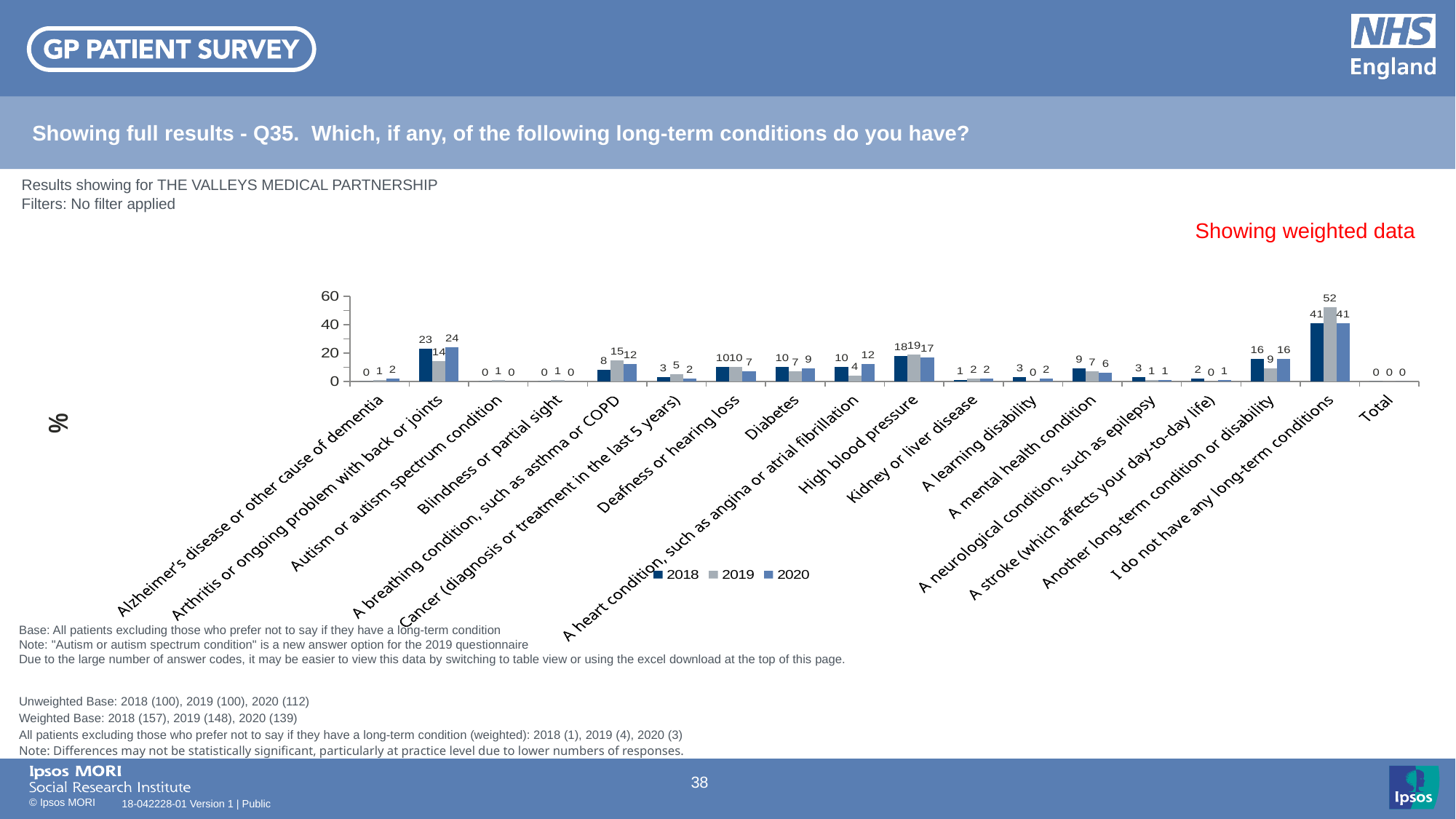
What kind of chart is shown on the slide? bar chart What is the difference between the 2019 and 2018 values for 'I do not have any long-term conditions'? 11 Which category has the highest 2019 value? I do not have any long-term conditions Which is larger: the 2018 value for 'A mental health condition' or the 2018 value for 'Diabetes'? Diabetes What is the 2018 value for 'High blood pressure'? 18 What is the difference between the 2020 and 2019 values for 'A heart condition, such as angina or atrial fibrillation'? 8 How many series does the legend list? 3 Is the 2019 value for 'I do not have any long-term conditions' greater or less than 40? greater What is the 2019 value for 'I do not have any long-term conditions'? 52 What is the 2019 value for 'A breathing condition, such as asthma or COPD'? 15 How many categories are shown on the x axis? 18 What is the 2020 value for 'Arthritis or ongoing problem with back or joints'? 24